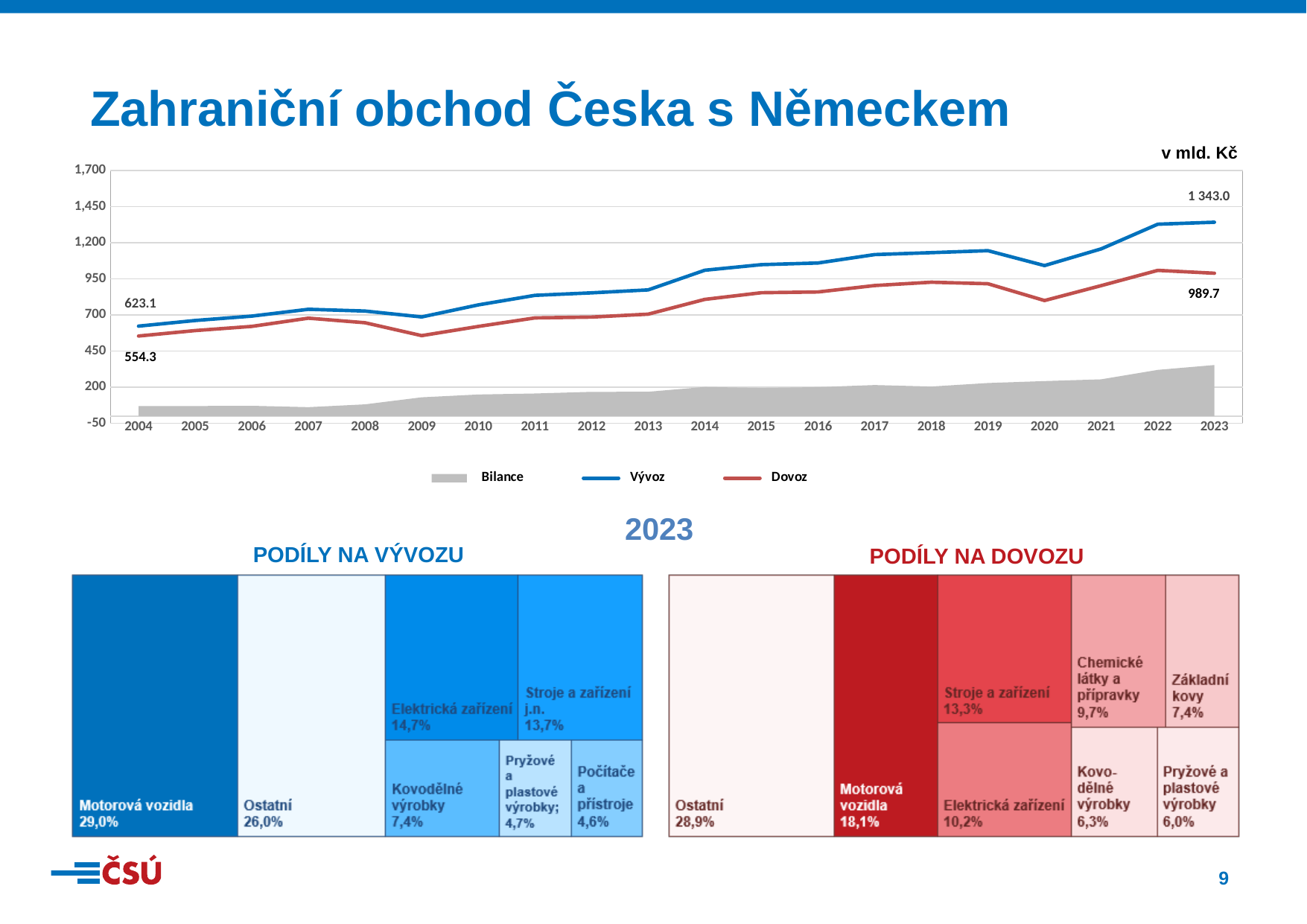
In the top line chart, is the value of Dovoz in 2009 greater or less than 700? less Which is larger: the share of Motorová vozidla in the PODÍLY NA VÝVOZU chart or in the PODÍLY NA DOVOZU chart? PODÍLY NA VÝVOZU (29,0%) In the top line chart, how many series does the legend list? 3 In the top line chart, what is the value of Dovoz in 2004? 554.3 In the top line chart, how many years are shown on the x axis? 20 In the top line chart, what is the value of Vývoz in 2023? 1 343.0 In the top line chart, does the Vývoz line generally rise or fall from 2004 to 2023? rise In the PODÍLY NA VÝVOZU chart, what share does Elektrická zařízení have? 14,7% In the PODÍLY NA DOVOZU chart, which category has the largest share? Ostatní In the PODÍLY NA DOVOZU chart, what share does Chemické látky a přípravky have? 9,7% In the top line chart, what is the difference between Vývoz and Dovoz in 2023? 353.3 In the top line chart, is the Bilance value in 2023 greater or less than 200? greater